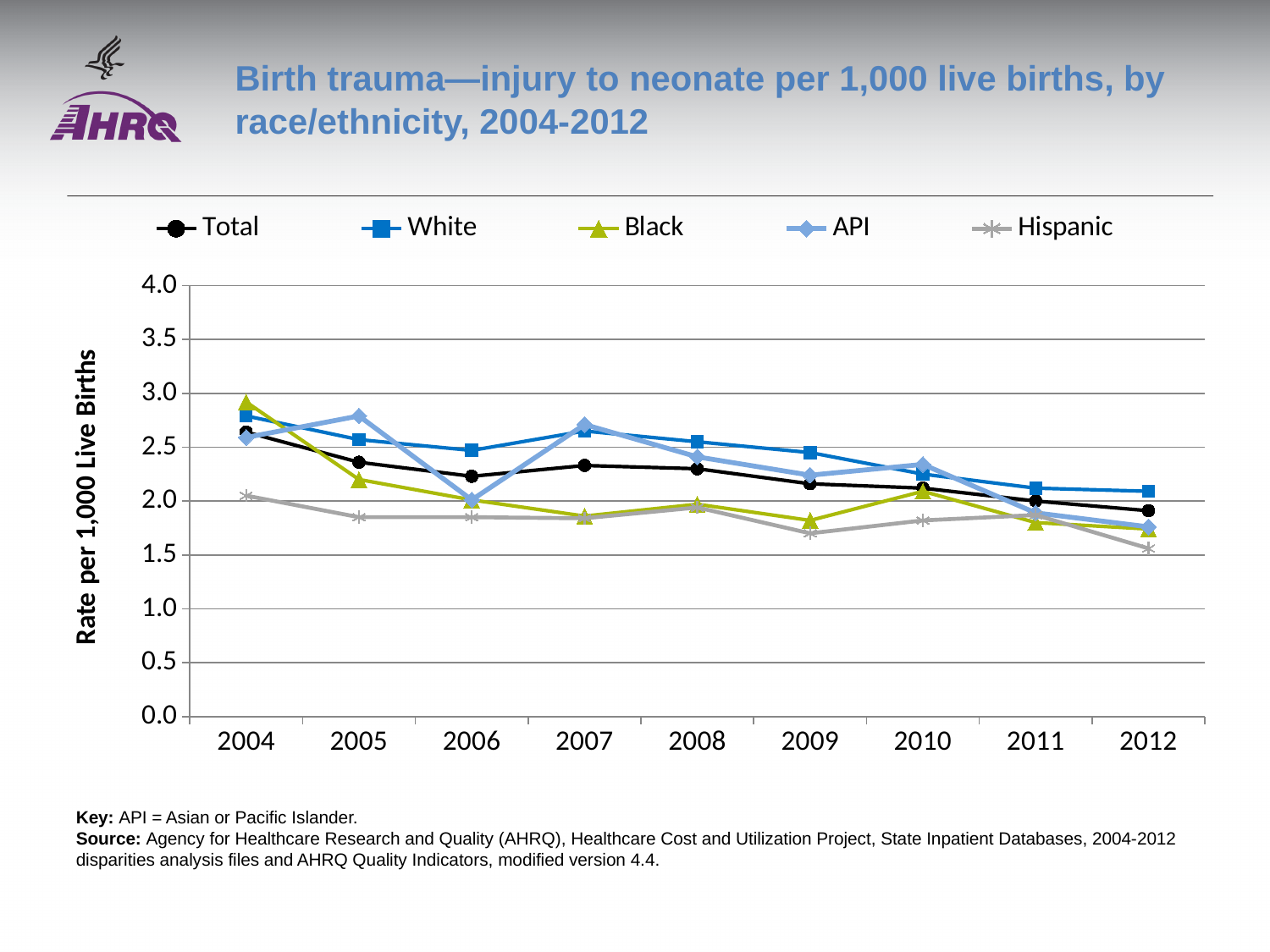
How many years are shown along the x axis? 9 What kind of chart is shown on the slide? Line chart Is the value for White in 2004 greater or less than 2.5? greater In 2012, which is larger, the value for White or the value for Hispanic? White Is the value for Hispanic in 2012 greater or less than 2.0? less Which group has the lowest rate in 2012? Hispanic Does the Total series rise or fall from 2004 to 2012? Falls Is the value for Black in 2004 greater or less than 2.5? greater How many series does the legend list? 5 What is the title of the y axis? Rate per 1,000 Live Births In 2006, which is larger, the value for White or the value for API? White